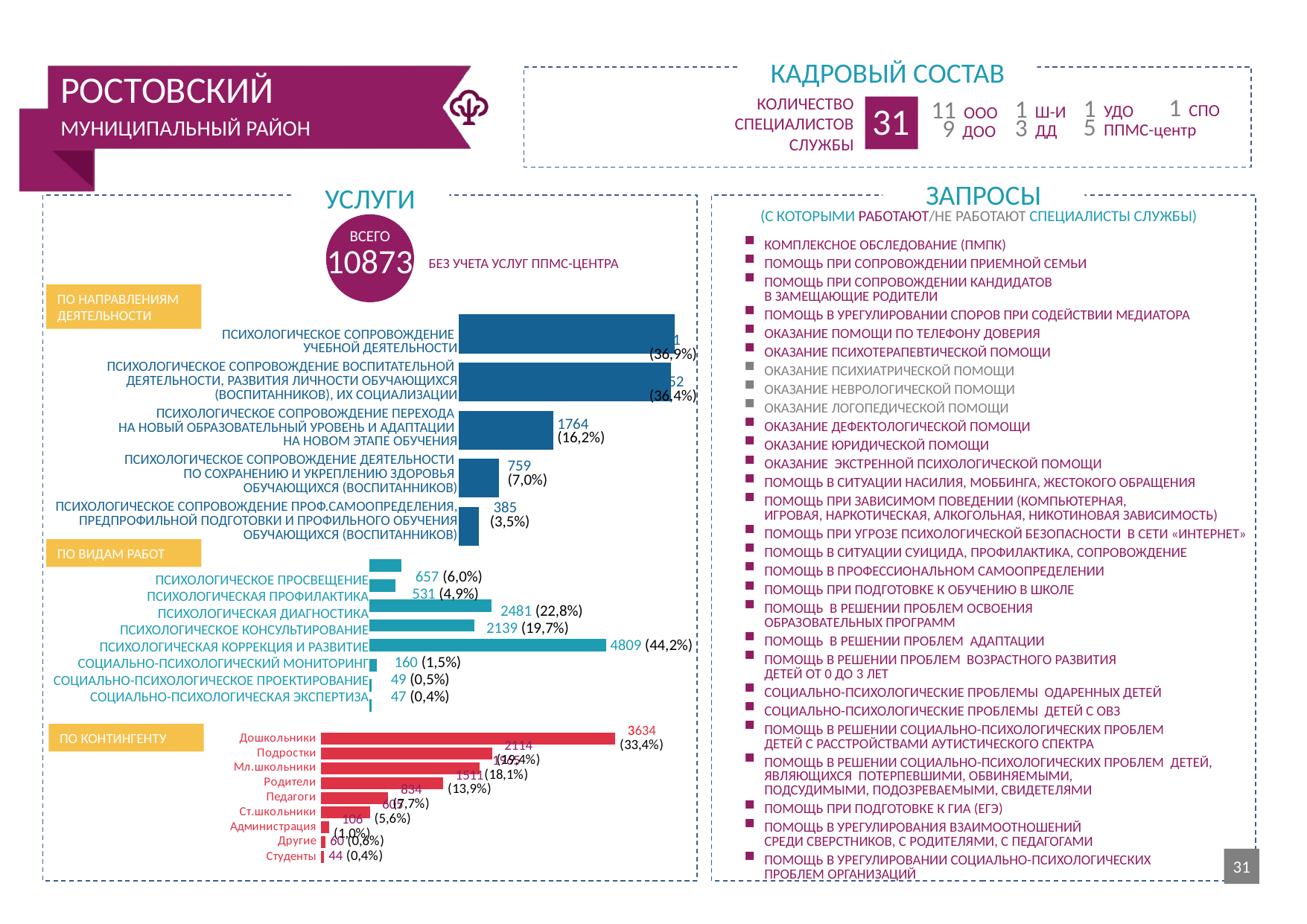
In the 'По видам работ' chart, which is larger: Психологическое просвещение or Психологическая профилактика? Психологическое просвещение In the 'По видам работ' chart, which category has the highest value? Психологическая коррекция и развитие In the 'По видам работ' chart, which category has the lowest value? Социально-психологическая экспертиза In the 'По направлениям деятельности' chart, which category has the lowest value? Психологическое сопровождение проф.самоопределения, предпрофильной подготовки и профильного обучения обучающихся (воспитанников) How many categories are shown in the 'По видам работ' chart? 8 In the 'По видам работ' chart, what is the value for Психологическая диагностика? 2481 (22,8%) In the 'По видам работ' chart, what is the value for Психологическая коррекция и развитие? 4809 (44,2%) In the 'По контингенту' chart, which category has the lowest value? Студенты In the 'По контингенту' chart, what is the value for Дошкольники? 3634 (33,4%) In the 'По направлениям деятельности' chart, what is the value for Психологическое сопровождение деятельности по сохранению и укреплению здоровья обучающихся (воспитанников)? 759 (7,0%) In the 'По контингенту' chart, what is the difference between Дошкольники and Родители? 2123 In the 'По видам работ' chart, what is the difference between Психологическая диагностика and Психологическое консультирование? 342